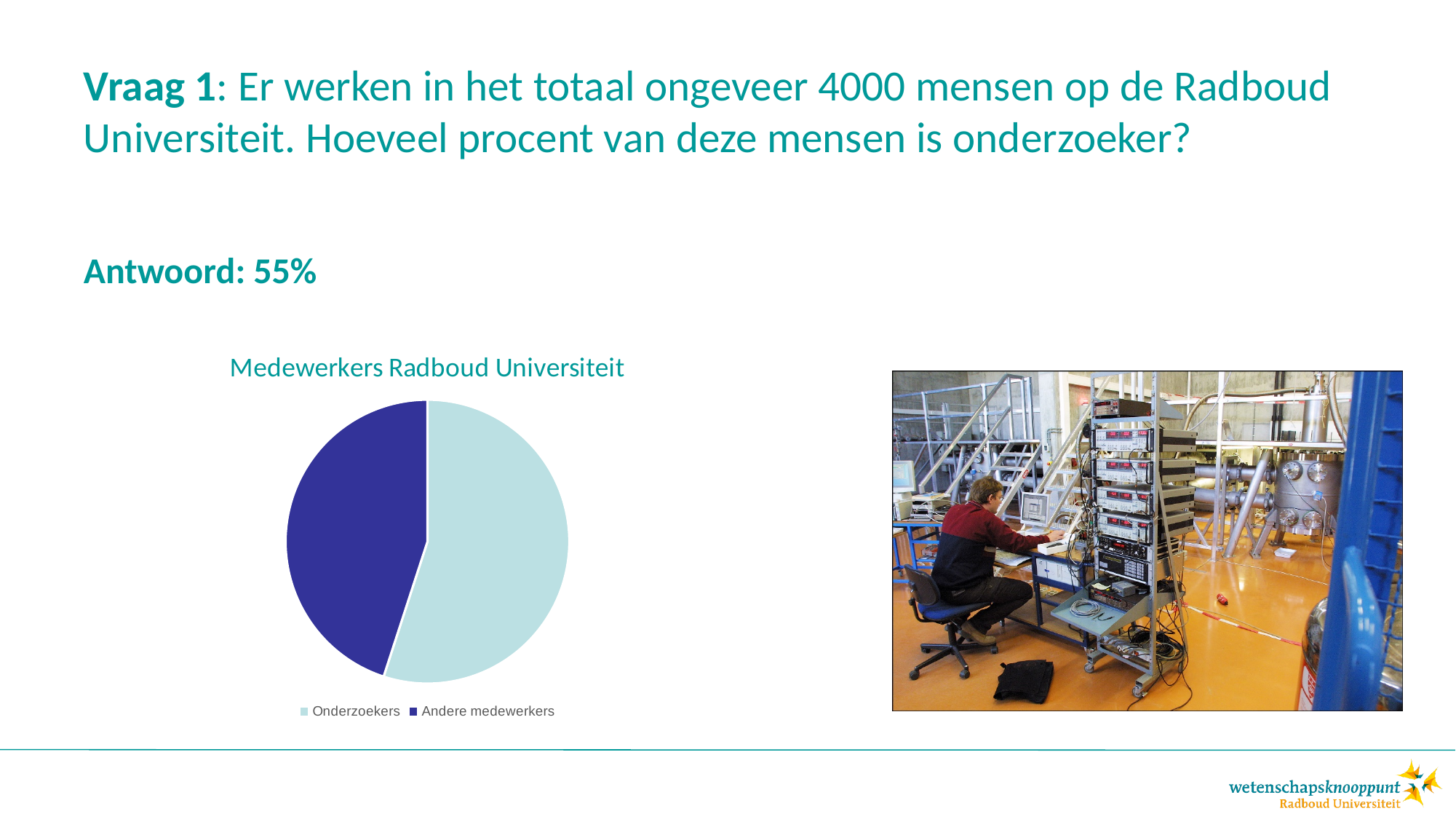
Which slice is larger: Onderzoekers or Andere medewerkers? Onderzoekers What kind of chart is shown on the slide? pie chart What is the title of the pie chart? Medewerkers Radboud Universiteit Is the share of Onderzoekers greater or less than 50%? greater According to the slide, what share of the pie does Onderzoekers represent? 55% What colour is the Onderzoekers slice in the pie chart? light teal Which category has the largest slice in the pie chart? Onderzoekers How many slices does the pie chart have? 2 Which category has the smallest slice in the pie chart? Andere medewerkers Is the share of Andere medewerkers greater or less than 50%? less How many entries does the legend of the pie chart list? 2